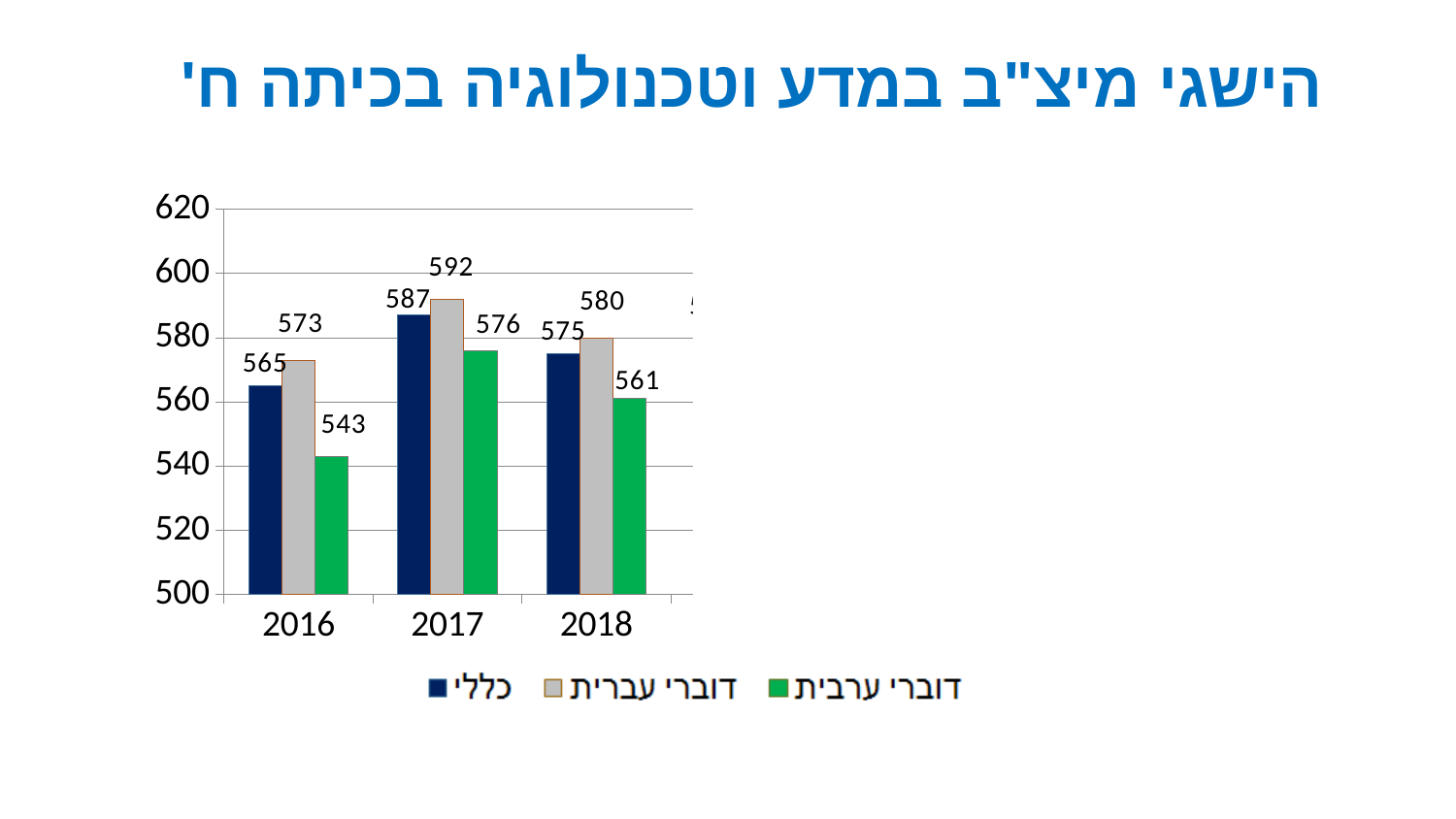
In which year is the value for כללי highest? 2017 In which year is the value for דוברי ערבית lowest? 2016 Which colour represents the דוברי ערבית series? green How many series does the legend list? 3 What is the difference between דוברי עברית and דוברי ערבית in 2016? 30 Is the value for דוברי ערבית in 2017 greater or less than 560? greater What is the value for דוברי עברית in 2017? 592 Which is larger in 2018: דוברי עברית or כללי? דוברי עברית What type of chart is shown on the slide? bar chart What is the value for דוברי ערבית in 2016? 543 What is the value for דוברי ערבית in 2018? 561 What is the value for כללי in 2016? 565